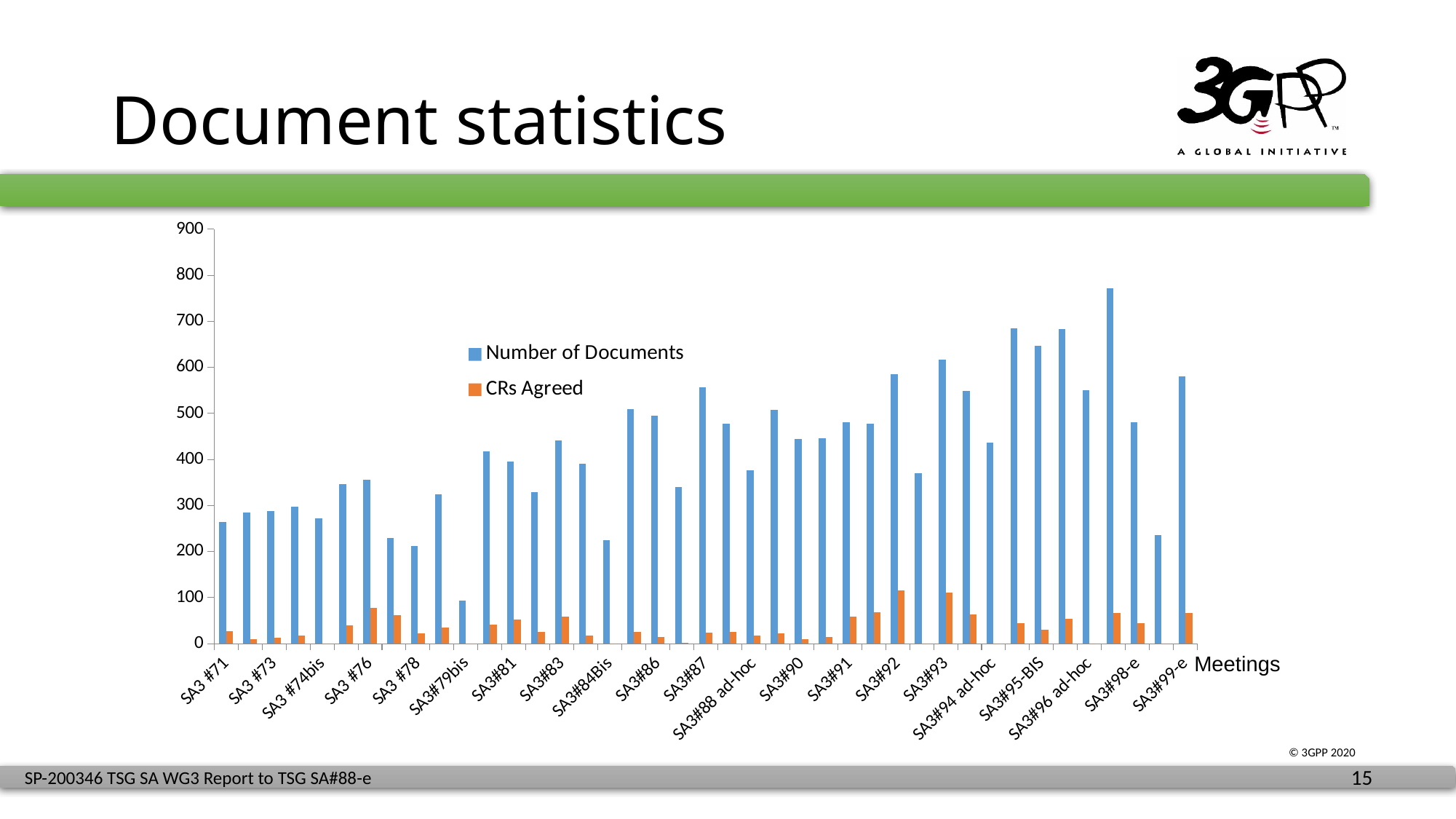
Is the Number of Documents for SA3#84Bis greater or less than 300? less Is the CRs Agreed value for SA3#92 greater or less than 100? greater Which labelled meeting has the lowest Number of Documents? SA3#79bis What are the two series named in the legend? Number of Documents; CRs Agreed Is the Number of Documents for SA3#93 greater or less than 500? greater Overall, does the Number of Documents tend to rise or fall from SA3 #71 to the later meetings? rise What is the title of the x axis? Meetings How many series does the legend list? 2 Which has a larger Number of Documents, SA3#93 or SA3 #71? SA3#93 What kind of chart is shown on the slide? bar chart